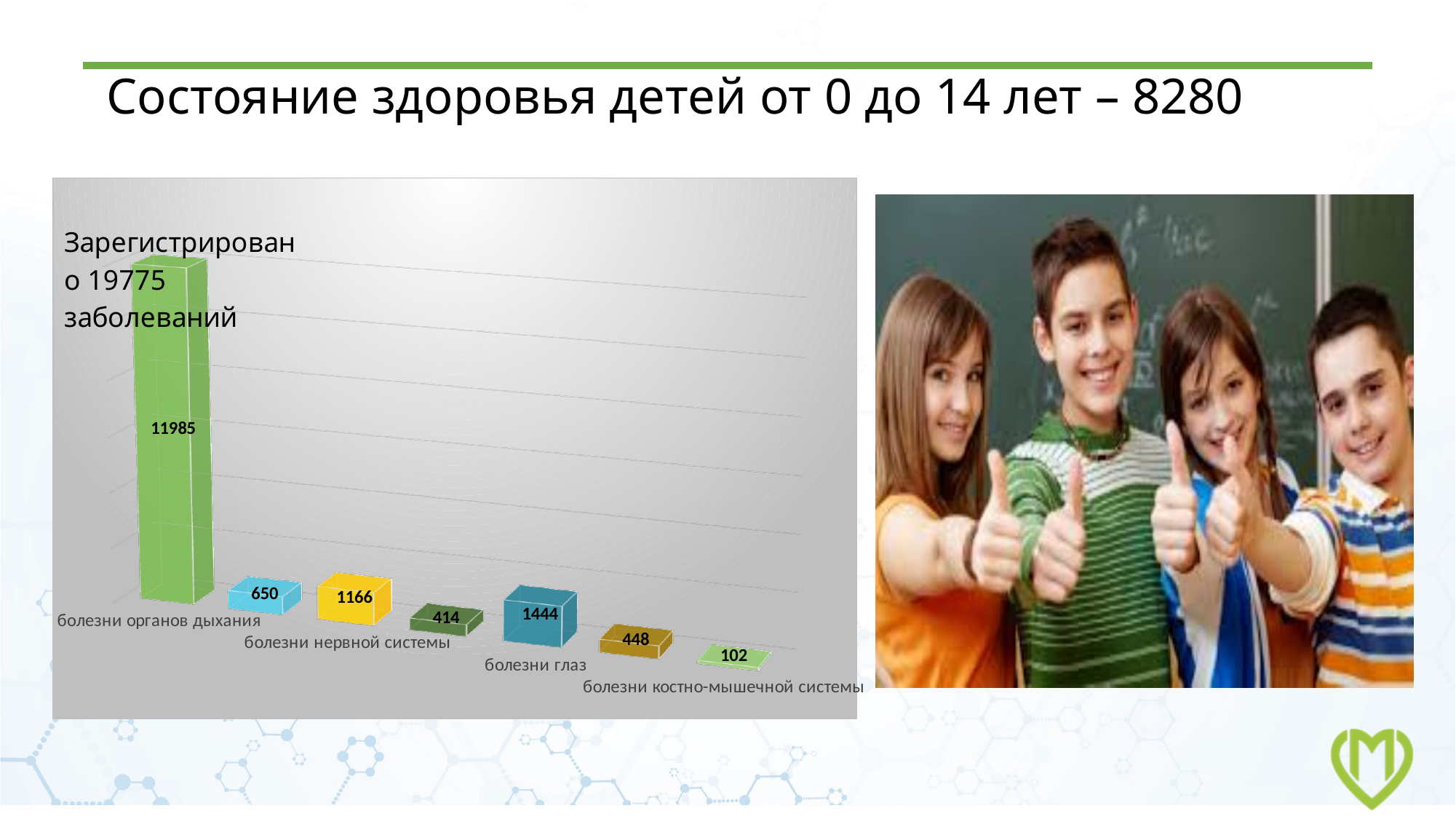
Which category has the lowest value? болезни костно-мышечной системы What is the value for болезни органов дыхания? 11985 What is the value for болезни нервной системы? 1166 What is the difference between the values for болезни глаз and болезни нервной системы? 278 What is the value for болезни глаз? 1444 What is the value for болезни костно-мышечной системы? 102 Which is larger, the value for болезни глаз or the value for болезни нервной системы? болезни глаз What is the difference between the values for болезни органов дыхания and болезни костно-мышечной системы? 11883 What kind of chart is shown on the slide? bar chart What total number of registered diseases is stated in the text on the chart? 19775 How many bars are plotted in the chart? 7 Which category has the highest value? болезни органов дыхания